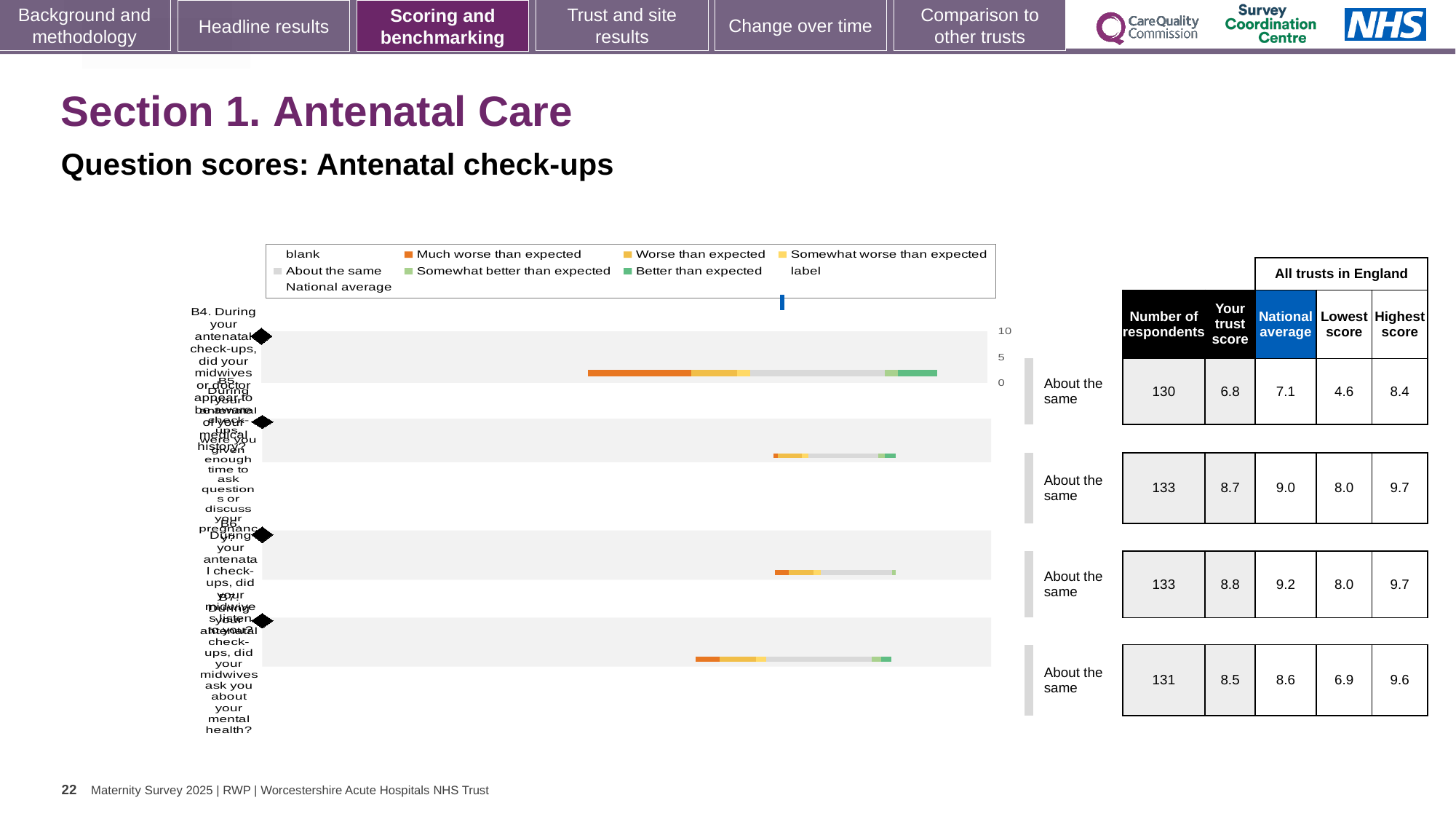
What colour does the chart legend use for 'Better than expected'? green In the table beside the chart, what is the National average for the second row (B5)? 9.0 In the table beside the chart, what is the difference between the National average and 'Your trust score' for the first row (B4)? 0.3 How many question rows (bars) are plotted in the chart? 4 What colour does the chart legend use for 'Much worse than expected'? orange In the table beside the chart, what is the Highest score for the fourth row (B7)? 9.6 What kind of chart is shown on the slide? bar chart What is the highest tick value shown on the chart's axis? 10 In the table beside the chart, which row has the lowest 'Your trust score'? B4 (6.8) In the table beside the chart, what is the 'Your trust score' for the first row (B4)? 6.8 In the table beside the chart, is the 'Your trust score' for the third row (B6) larger or smaller than its National average? smaller In the table beside the chart, what is the Number of respondents for the fourth row (B7)? 131